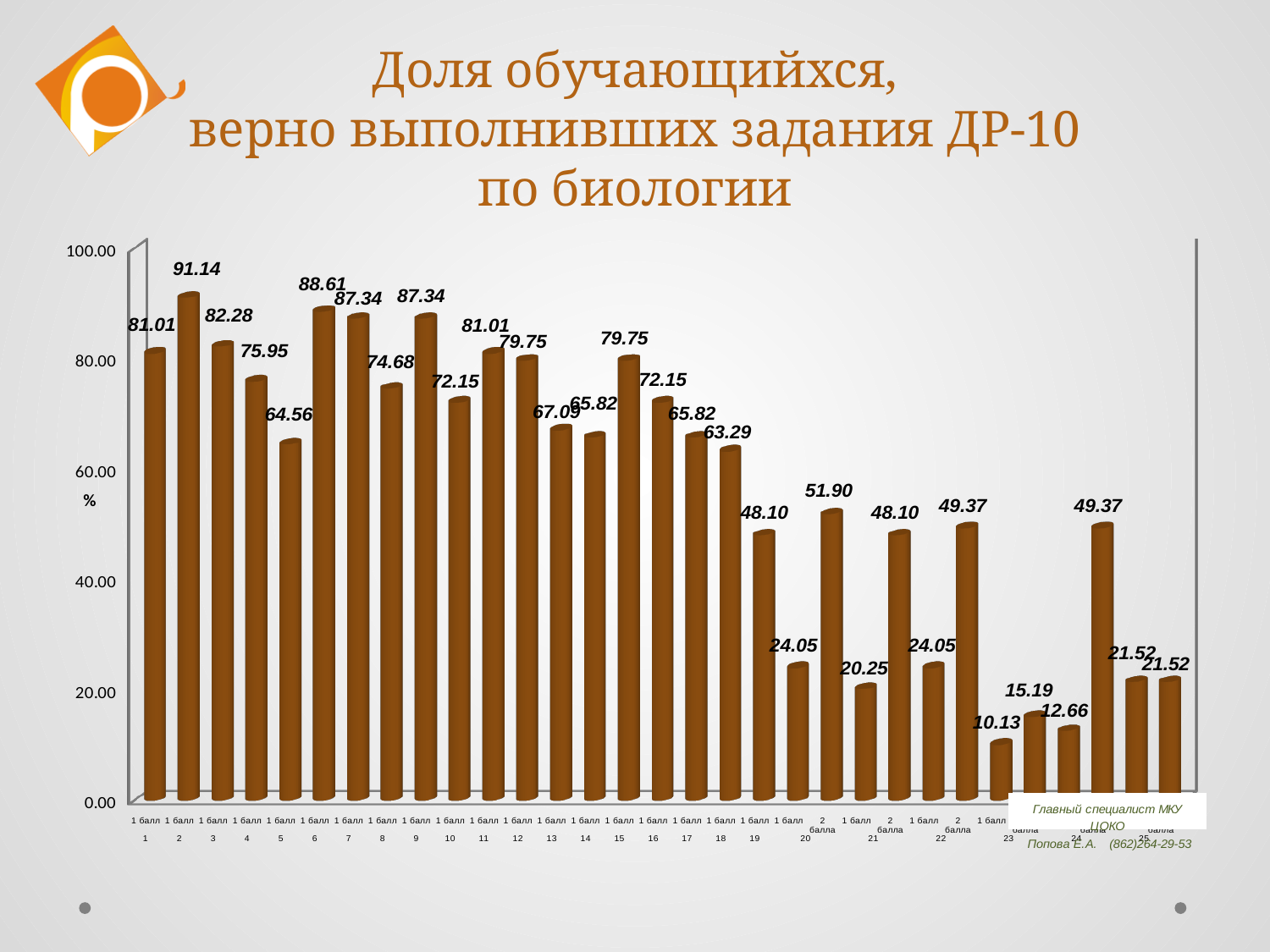
What is the value for task 19? 48.10 What is the difference between the values for task 2 and task 1? 10.13 Is the value for task 18 greater or less than 60? greater What is the lowest value shown on the chart? 10.13 What is the value for task 5? 64.56 What kind of chart is shown on the slide? bar chart What is the difference between the '2 балла' and '1 балл' values for task 20? 27.85 What is the value for task 2? 91.14 Which is larger, the value for task 6 or task 7? task 6 What unit is shown on the y axis? % Which task has the highest value? 2 What is the value for '2 балла' in task 20? 51.90